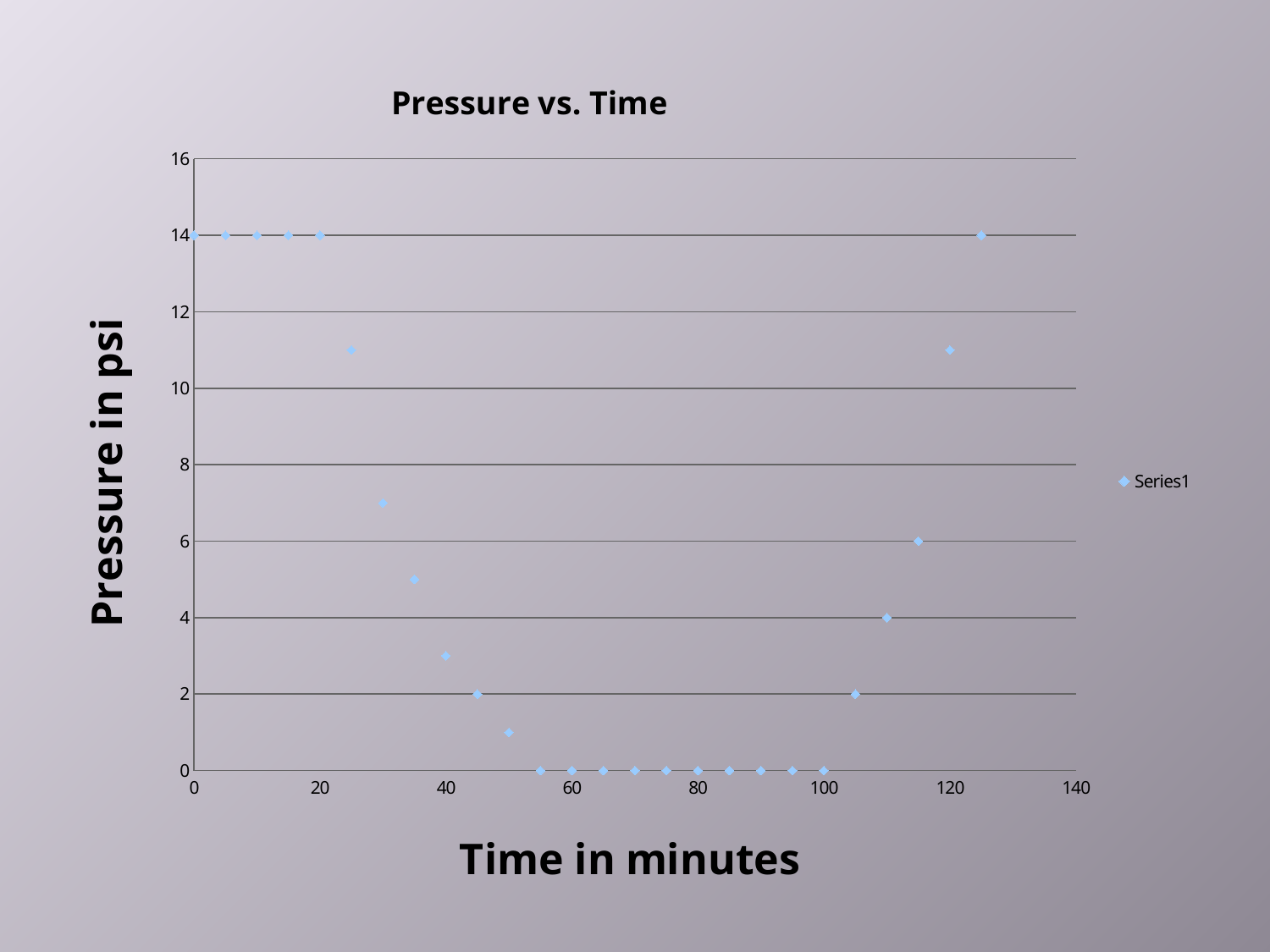
What is the pressure at time 20 minutes? 14 What is the pressure at time 100 minutes? 0 What is the label of the vertical axis? Pressure in psi What is the highest pressure value plotted on the chart? 14 Do the pressure values rise or fall between 20 and 60 minutes? fall How many series does the legend list? 1 What kind of chart is shown on the slide? scatter chart Is the pressure at 40 minutes greater or less than 4? less What is the pressure at time 60 minutes? 0 What is the title of the chart? Pressure vs. Time What is the lowest pressure value plotted on the chart? 0 What is the pressure at time 0 minutes? 14